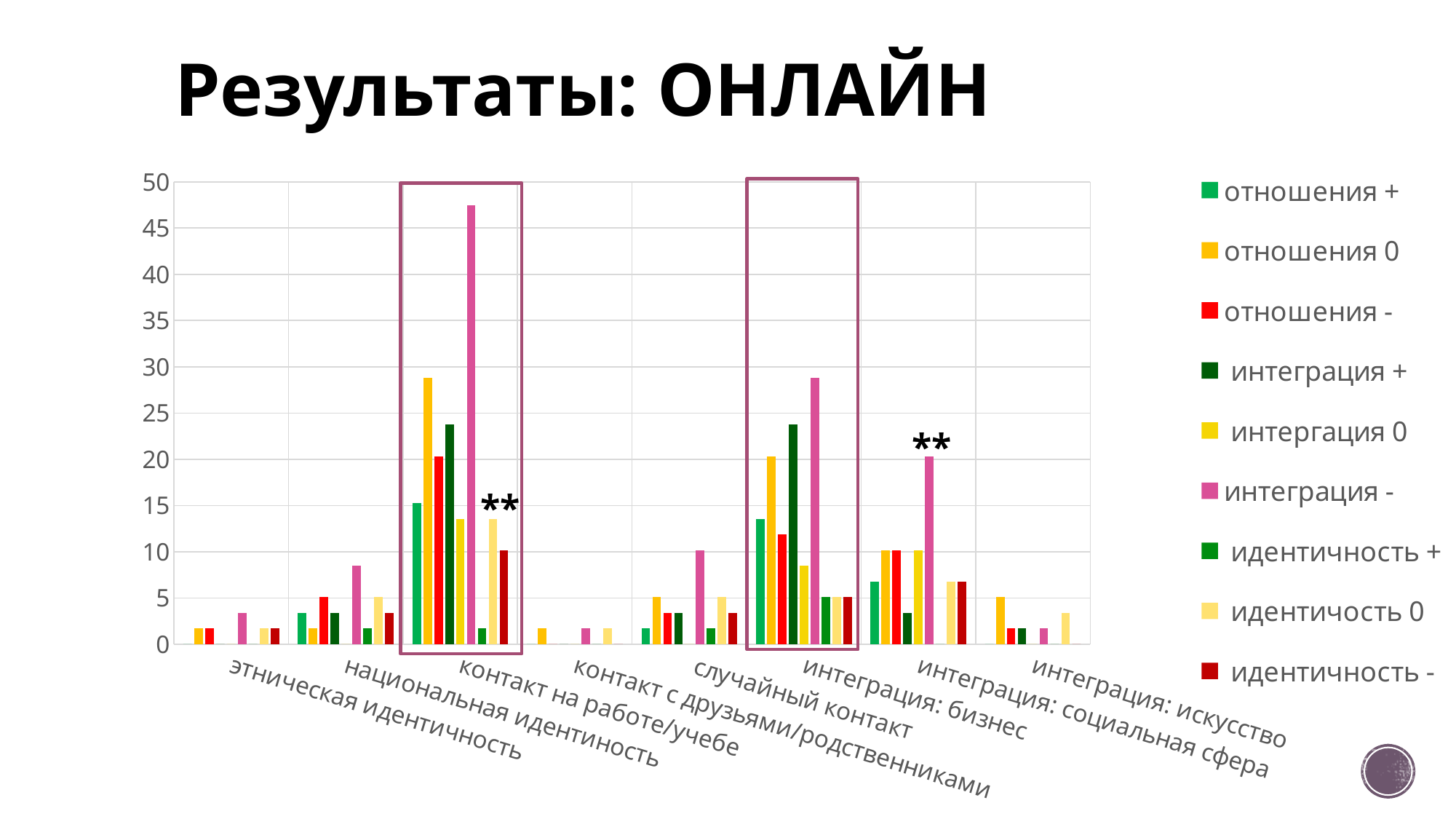
Is the value of 'отношения +' for 'случайный контакт' greater or less than 10? less Is the value of 'отношения 0' for 'контакт на работе/учебе' greater or less than 25? greater What is the title of the slide containing the chart? Результаты: ОНЛАЙН Is the value of 'интеграция -' for 'контакт на работе/учебе' greater or less than 40? greater Which category contains the tallest bar in the chart? контакт на работе/учебе How many categories are shown along the x axis of the chart? 8 Which is larger: the 'интеграция -' bar for 'контакт на работе/учебе' or the 'интеграция -' bar for 'интеграция: бизнес'? контакт на работе/учебе In the category 'контакт на работе/учебе', which is larger: 'отношения 0' or 'отношения +'? отношения 0 How many series does the chart's legend list? 9 What kind of chart is shown on the slide? bar chart Which series has the tallest bar in the category 'контакт на работе/учебе'? интеграция -